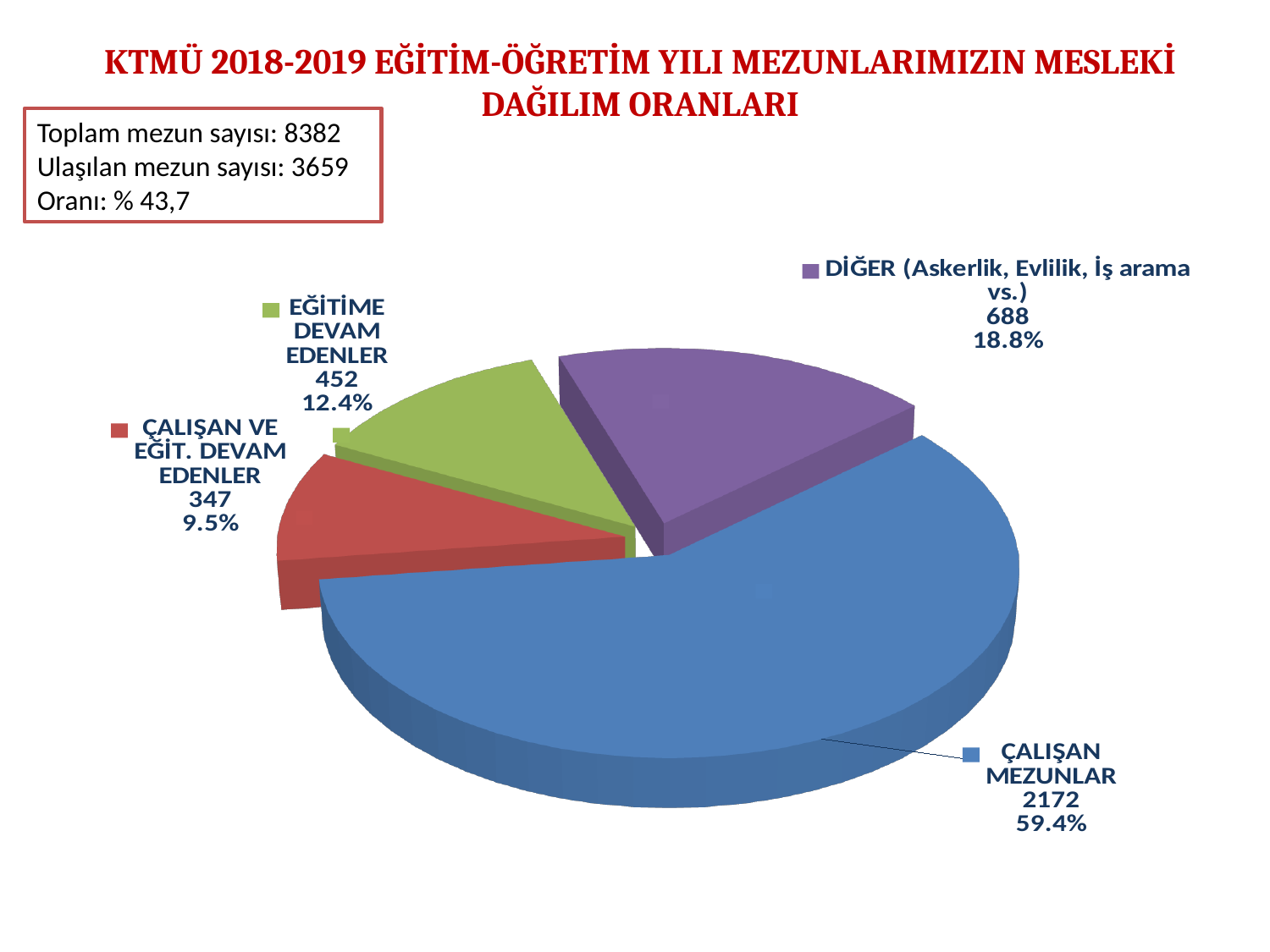
What is the value for EĞİTİME DEVAM EDENLER? 452 Which category has the smallest slice? ÇALIŞAN VE EĞİT. DEVAM EDENLER How many slices does the pie chart have? 4 What is the difference between the values for ÇALIŞAN MEZUNLAR and DİĞER (Askerlik, Evlilik, İş arama vs.)? 1484 Which is larger, the value for EĞİTİME DEVAM EDENLER or the value for ÇALIŞAN VE EĞİT. DEVAM EDENLER? EĞİTİME DEVAM EDENLER Which category has the largest slice? ÇALIŞAN MEZUNLAR What kind of chart is shown on the slide? Pie chart What is the value for ÇALIŞAN VE EĞİT. DEVAM EDENLER? 347 What is the value for ÇALIŞAN MEZUNLAR? 2172 What is the value for DİĞER (Askerlik, Evlilik, İş arama vs.)? 688 What share of the pie does DİĞER (Askerlik, Evlilik, İş arama vs.) represent? 18.8% What share of the pie does ÇALIŞAN MEZUNLAR represent? 59.4%